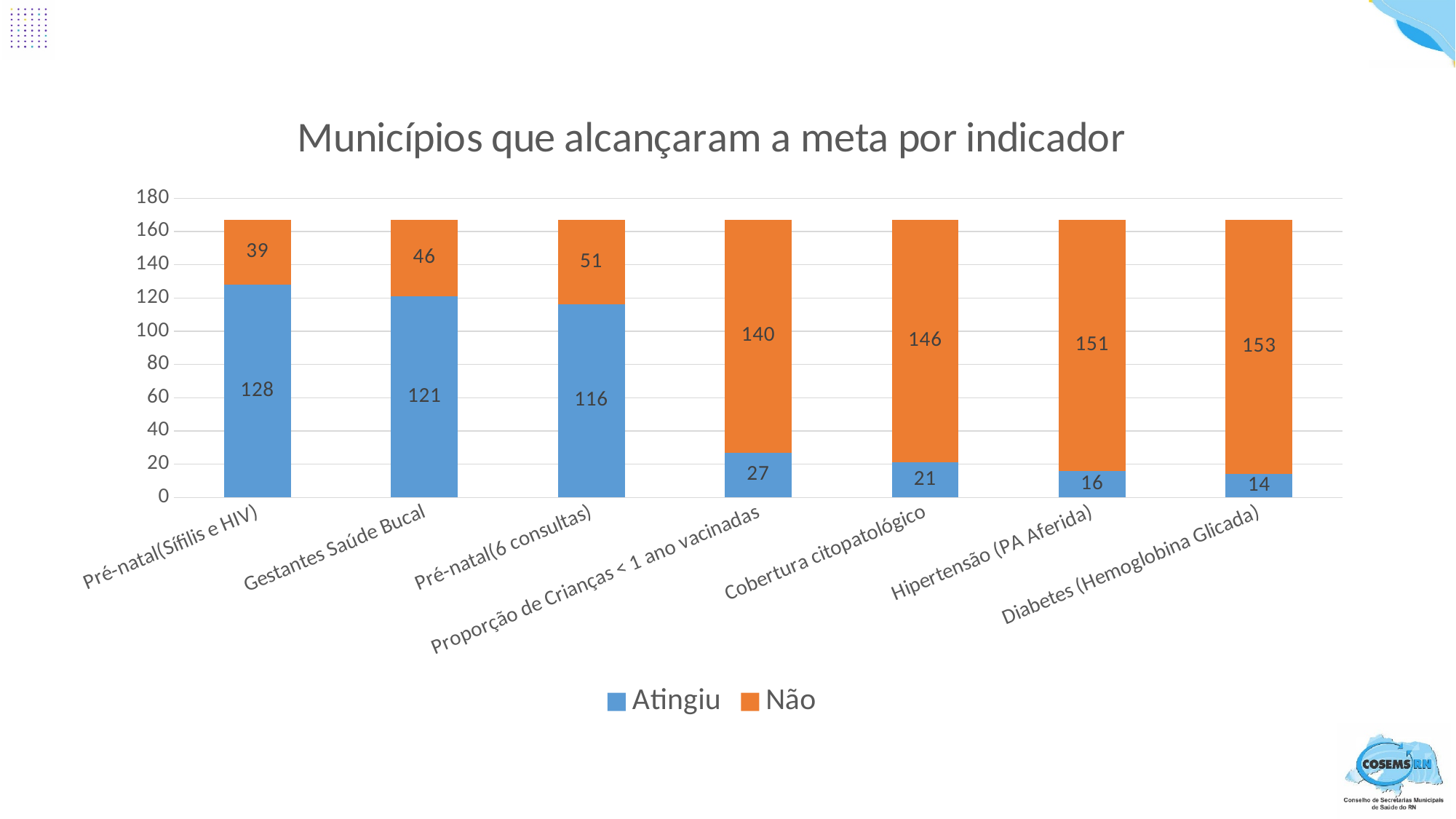
What kind of chart is shown on the slide? Stacked bar chart Which category has the lowest Não value? Pré-natal(Sífilis e HIV) Which category has the highest Atingiu value? Pré-natal(Sífilis e HIV) How many series does the legend list? 2 What is the total of the stacked bar for Proporção de Crianças < 1 ano vacinadas? 167 Which is larger: the Atingiu value for Gestantes Saúde Bucal or for Pré-natal(6 consultas)? Gestantes Saúde Bucal What is the Não value for Cobertura citopatológico? 146 How many categories are shown on the x axis? 7 What is the Atingiu value for Diabetes (Hemoglobina Glicada)? 14 What is the Atingiu value for Pré-natal(Sífilis e HIV)? 128 What is the difference between the Não values for Diabetes (Hemoglobina Glicada) and Hipertensão (PA Aferida)? 2 What is the title of the chart? Municípios que alcançaram a meta por indicador